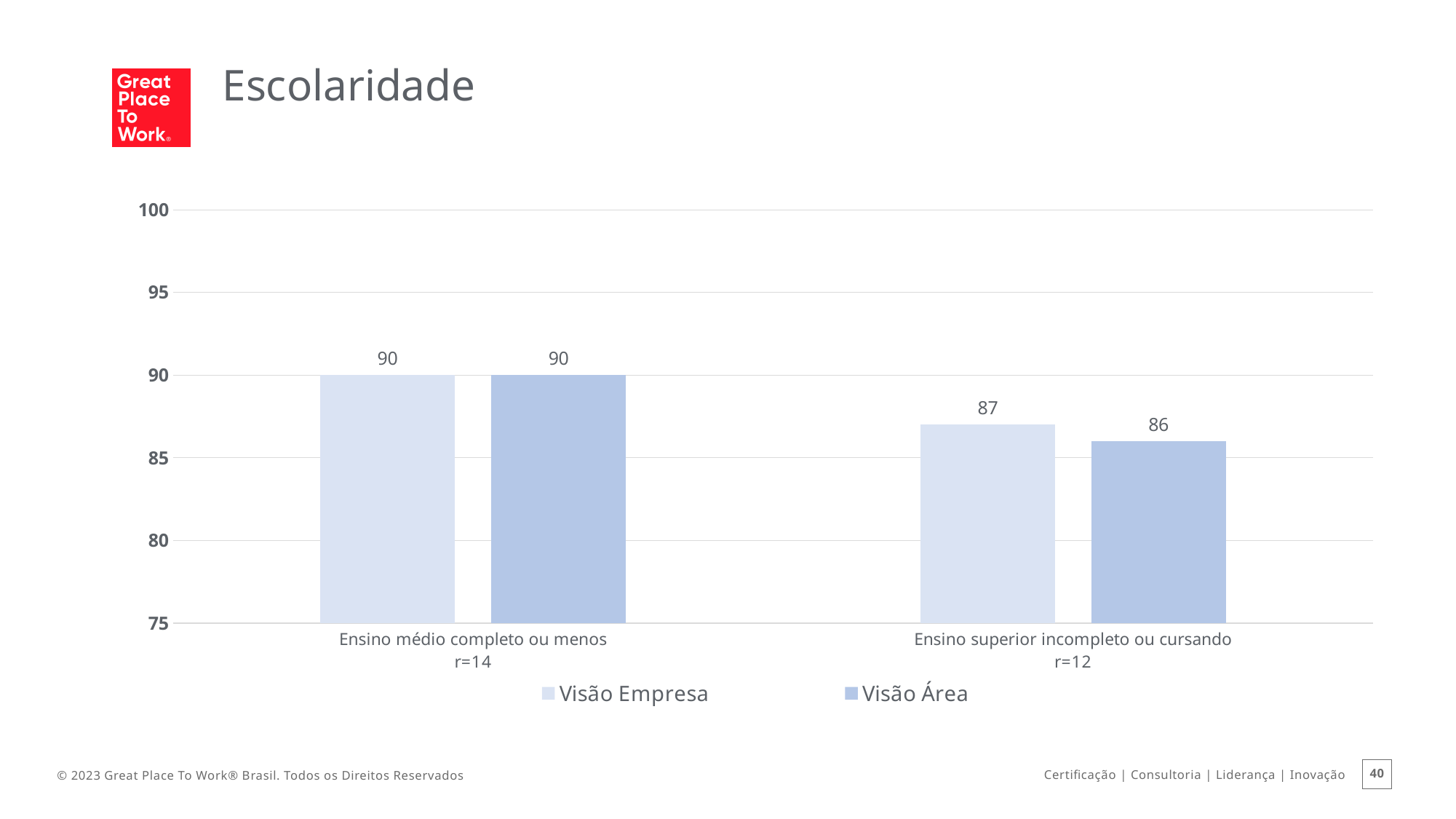
How many series does the legend list? 2 What is the Visão Área value for 'Ensino médio completo ou menos'? 90 How many categories are shown on the x axis? 2 Which category has the lowest Visão Área value? Ensino superior incompleto ou cursando What is the Visão Empresa value for 'Ensino superior incompleto ou cursando'? 87 Which category has the highest Visão Empresa value? Ensino médio completo ou menos What is the Visão Área value for 'Ensino superior incompleto ou cursando'? 86 What is the difference between the Visão Empresa values for 'Ensino médio completo ou menos' and 'Ensino superior incompleto ou cursando'? 3 What is the Visão Empresa value for 'Ensino médio completo ou menos'? 90 Which is larger: the Visão Área value for 'Ensino médio completo ou menos' or for 'Ensino superior incompleto ou cursando'? Ensino médio completo ou menos What kind of chart is shown on the slide? Bar chart What is the difference between the Visão Empresa and Visão Área values for 'Ensino superior incompleto ou cursando'? 1